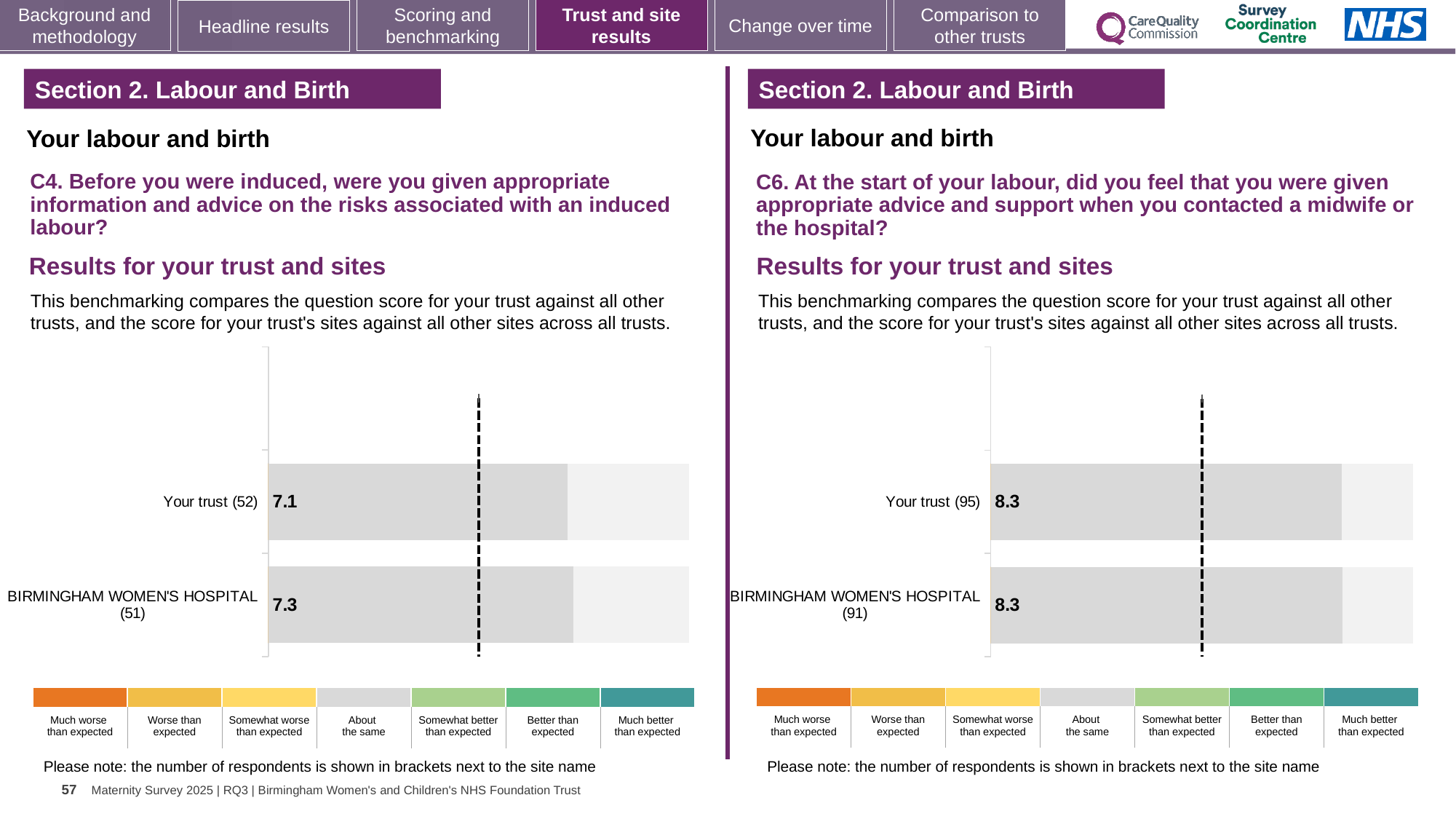
On the right chart (C6), what is the score for Your trust? 8.3 How many bars are plotted on the left chart (C4)? 2 On the right chart (C6), what is the score for BIRMINGHAM WOMEN'S HOSPITAL? 8.3 What type of chart is used on the right (C6)? Bar chart On the right chart (C6), how many respondents are shown in brackets for BIRMINGHAM WOMEN'S HOSPITAL? 91 On the left chart (C4), what is the score for BIRMINGHAM WOMEN'S HOSPITAL? 7.3 On the left chart (C4), which bar has the lowest score? Your trust On the left chart (C4), how many respondents are shown in brackets for Your trust? 52 On the left chart (C4), what is the difference between the BIRMINGHAM WOMEN'S HOSPITAL score and the Your trust score? 0.2 On the left chart (C4), which has the higher score, Your trust or BIRMINGHAM WOMEN'S HOSPITAL? BIRMINGHAM WOMEN'S HOSPITAL On the left chart (C4), what is the score for Your trust? 7.1 On the right chart (C6), what is the difference between the Your trust score and the BIRMINGHAM WOMEN'S HOSPITAL score? 0